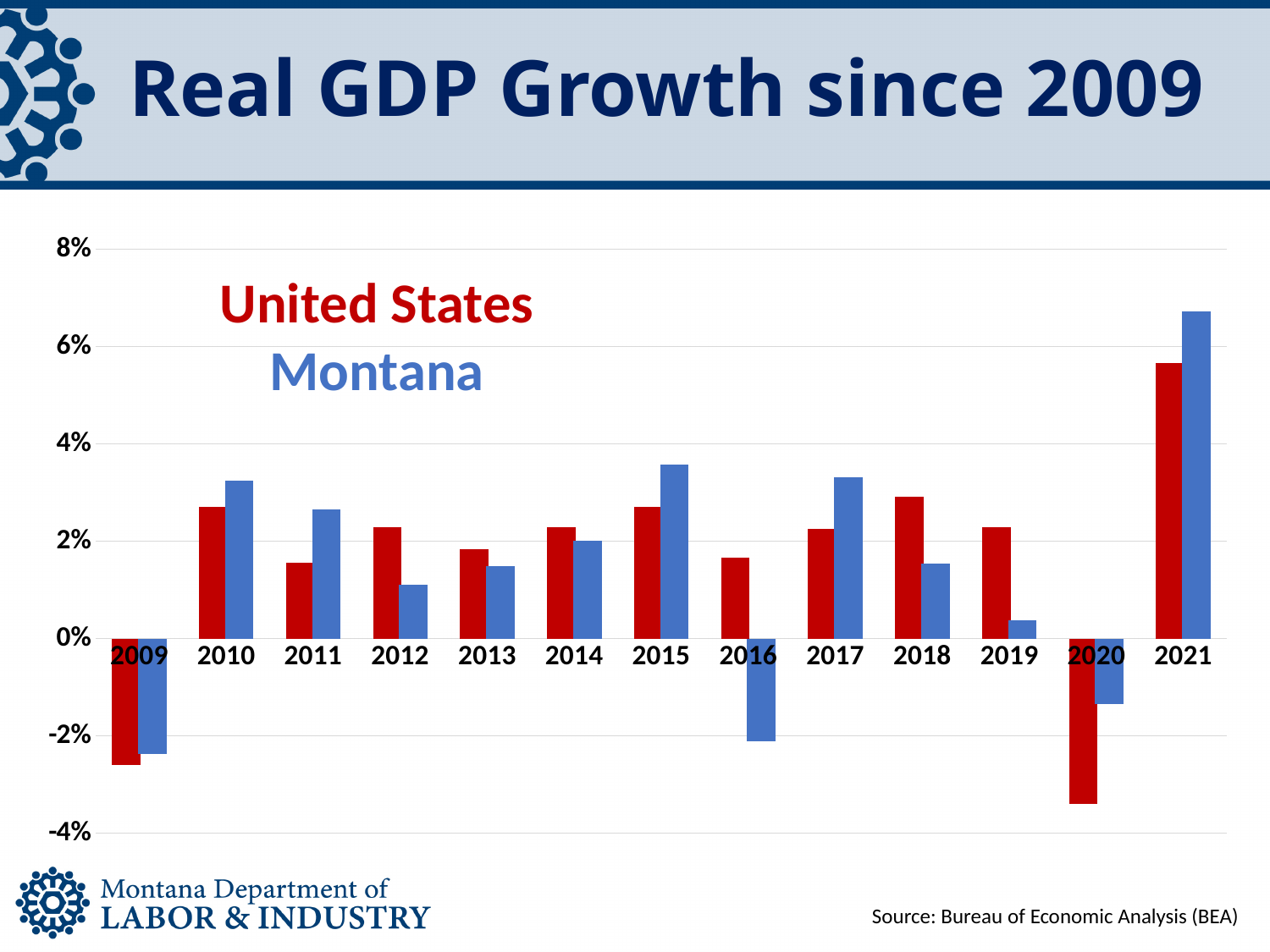
In 2016, which is larger: the United States value or the Montana value? United States In which year is Montana's real GDP growth the highest? 2021 What colour are the bars for the Montana series? Blue In which year is the United States' real GDP growth the lowest? 2020 In 2017, which is larger: the United States value or the Montana value? Montana How many series does the chart show? 2 What kind of chart is shown on the slide? Bar chart Is the United States value for 2020 greater or less than -2%? less Is the Montana value for 2021 greater or less than 6%? greater In which year is the United States' real GDP growth the highest? 2021 How many years are shown on the x axis of the chart? 13 Is the Montana value for 2019 greater or less than 2%? less